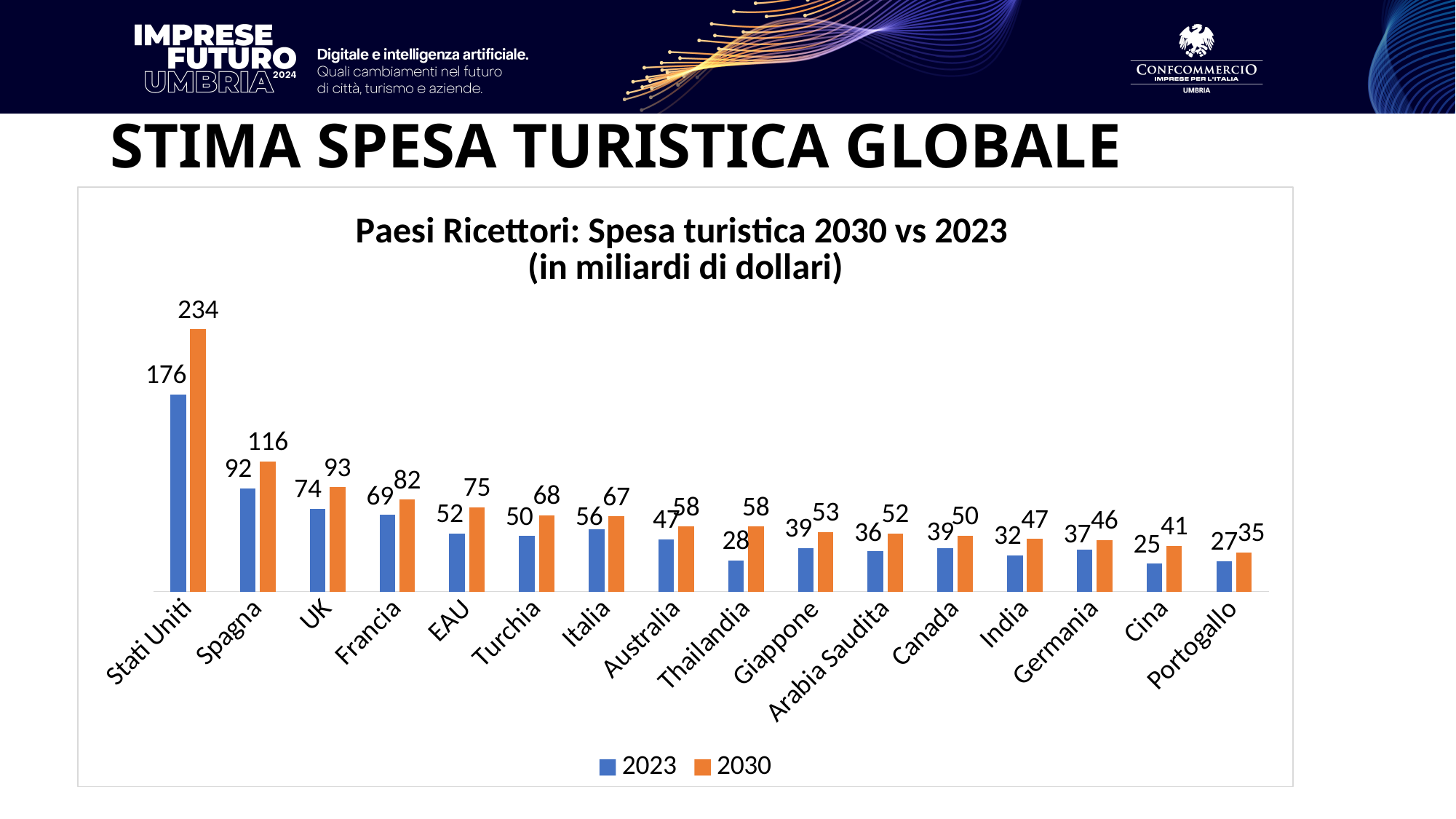
What colour represents the 2030 series? Orange What kind of chart is shown? Bar chart What is the 2030 value for Stati Uniti? 234 How many series does the legend list? 2 Which country has the lowest 2023 value? Cina Do the 2030 values generally rise or fall from left to right along the x axis? Fall Which country has the highest 2023 value? Stati Uniti What is the difference between the 2030 and 2023 values for Spagna? 24 What is the 2030 value for Thailandia? 58 How many countries are shown on the x axis? 16 What is the 2023 value for Italia? 56 Which is larger, the 2030 value for Francia or the 2030 value for EAU? Francia